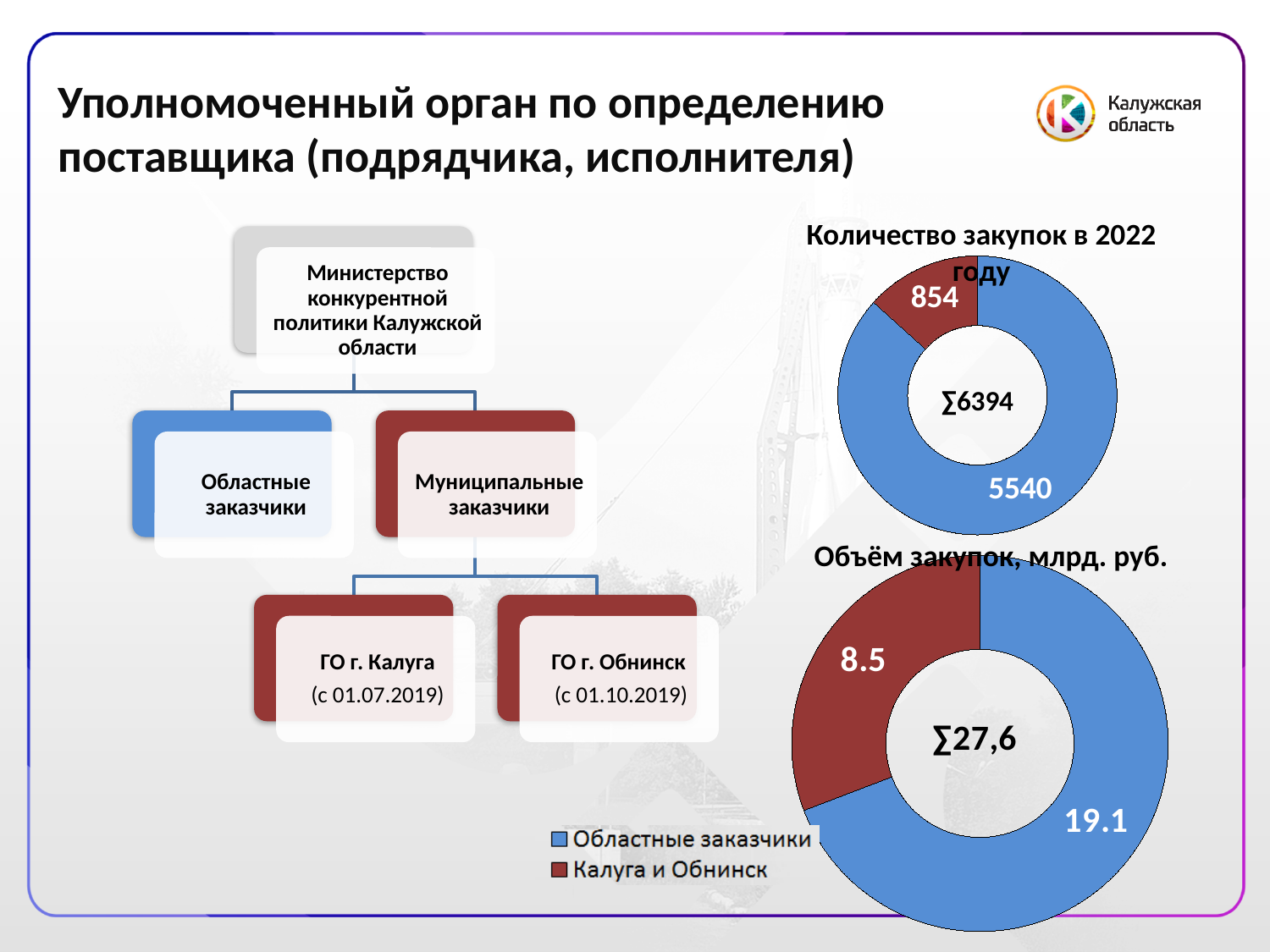
What kind of chart is 'Объём закупок, млрд. руб.'? Doughnut chart In the chart 'Объём закупок, млрд. руб.', which category has the smallest share? Калуга и Обнинск In the chart 'Объём закупок, млрд. руб.', what total is shown in the centre of the doughnut? ∑27,6 In the chart 'Количество закупок в 2022 году', what is the difference between the values for Областные заказчики and Калуга и Обнинск? 4686 In the chart 'Количество закупок в 2022 году', what is the value for Областные заказчики? 5540 In the chart 'Объём закупок, млрд. руб.', what is the value for Калуга и Обнинск? 8.5 In the chart 'Объём закупок, млрд. руб.', what is the difference between the values for Областные заказчики and Калуга и Обнинск? 10.6 In the chart 'Количество закупок в 2022 году', what is the value for Калуга и Обнинск? 854 In the chart 'Количество закупок в 2022 году', which category has the largest share? Областные заказчики How many entries does the legend shared by the two charts list? 2 In the chart 'Количество закупок в 2022 году', what total is shown in the centre of the doughnut? ∑6394 In the chart 'Объём закупок, млрд. руб.', what is the value for Областные заказчики? 19.1